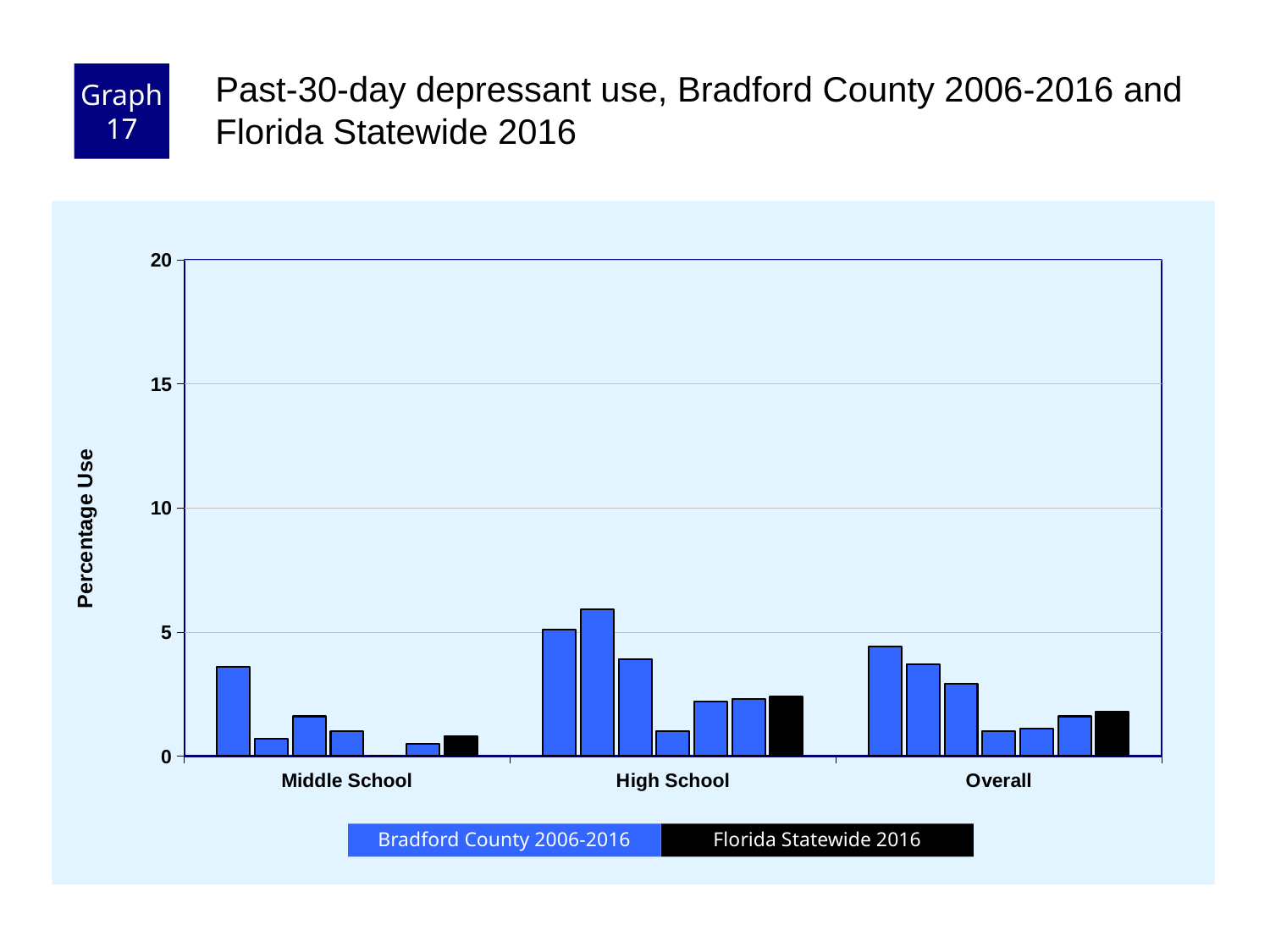
Which category has the highest Florida Statewide 2016 value? High School Is the Florida Statewide 2016 value larger for High School or for Middle School? High School How many series does the legend list? 2 How many school-level categories are shown on the x axis? 3 What is the label of the y axis? Percentage Use Is the tallest Bradford County bar in the Middle School group greater or less than 5? less Is the Florida Statewide 2016 value for High School greater or less than 5? less Which category has the lowest Florida Statewide 2016 value? Middle School Is the tallest Bradford County bar in the High School group greater or less than 5? greater What kind of chart is shown on the slide? bar chart What are the two series named in the legend? Bradford County 2006-2016 and Florida Statewide 2016